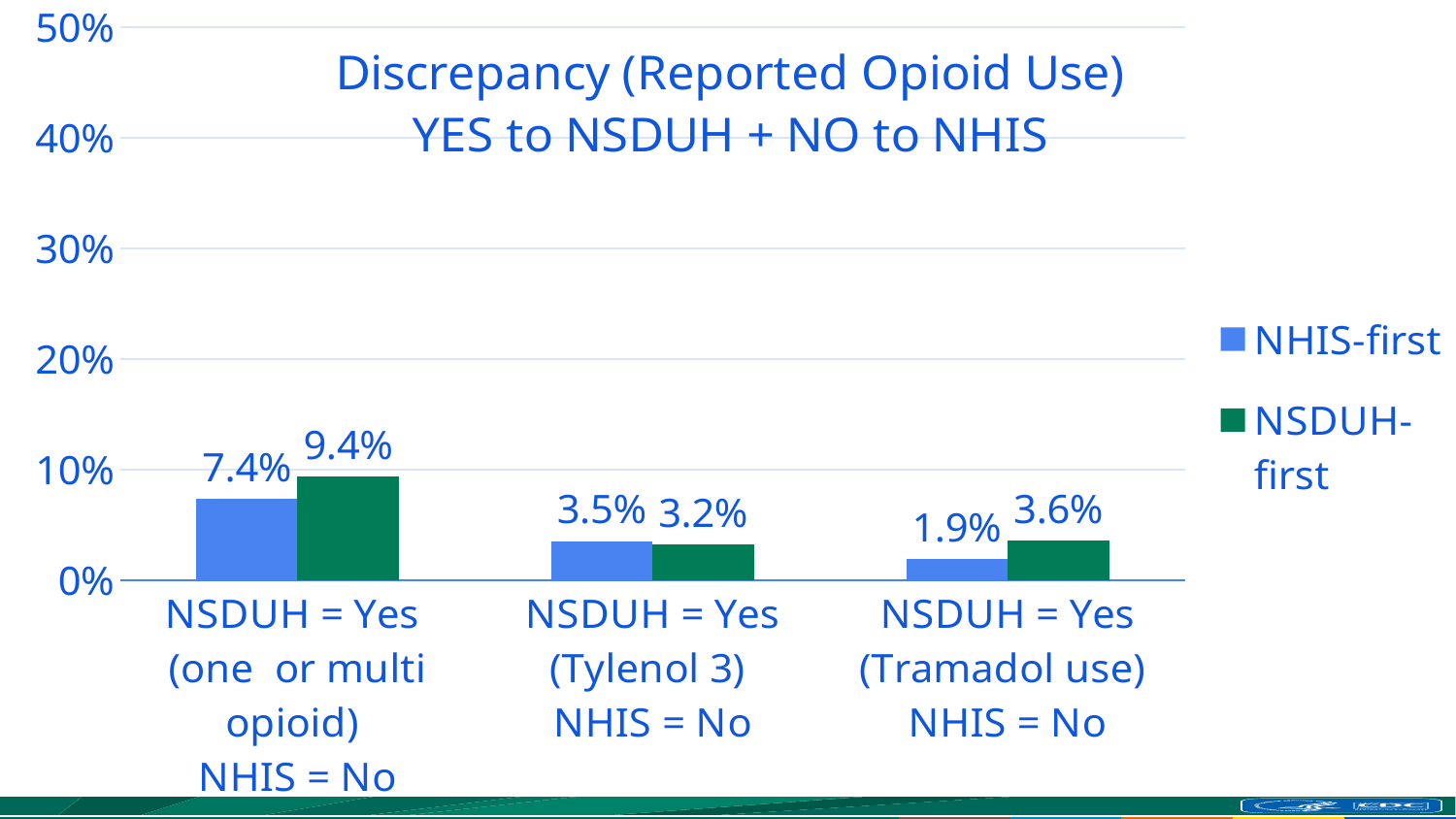
What is the difference between the NSDUH-first and NHIS-first values for the 'NSDUH = Yes (Tramadol use) NHIS = No' category? 1.7% Is the NSDUH-first value for the 'NSDUH = Yes (one or multi opioid) NHIS = No' category greater or less than 10%? less For the 'NSDUH = Yes (Tylenol 3) NHIS = No' category, which series has the larger value, NHIS-first or NSDUH-first? NHIS-first What is the difference between the NSDUH-first and NHIS-first values for the 'NSDUH = Yes (one or multi opioid) NHIS = No' category? 2.0% What is the NSDUH-first value for the 'NSDUH = Yes (Tylenol 3) NHIS = No' category? 3.2% Which category has the lowest NHIS-first value? NSDUH = Yes (Tramadol use) NHIS = No Which category has the highest NSDUH-first value? NSDUH = Yes (one or multi opioid) NHIS = No What kind of chart is shown on the slide? bar chart How many categories are shown on the x axis? 3 How many series does the legend list? 2 What is the NSDUH-first value for the 'NSDUH = Yes (Tramadol use) NHIS = No' category? 3.6% What is the NHIS-first value for the 'NSDUH = Yes (one or multi opioid) NHIS = No' category? 7.4%